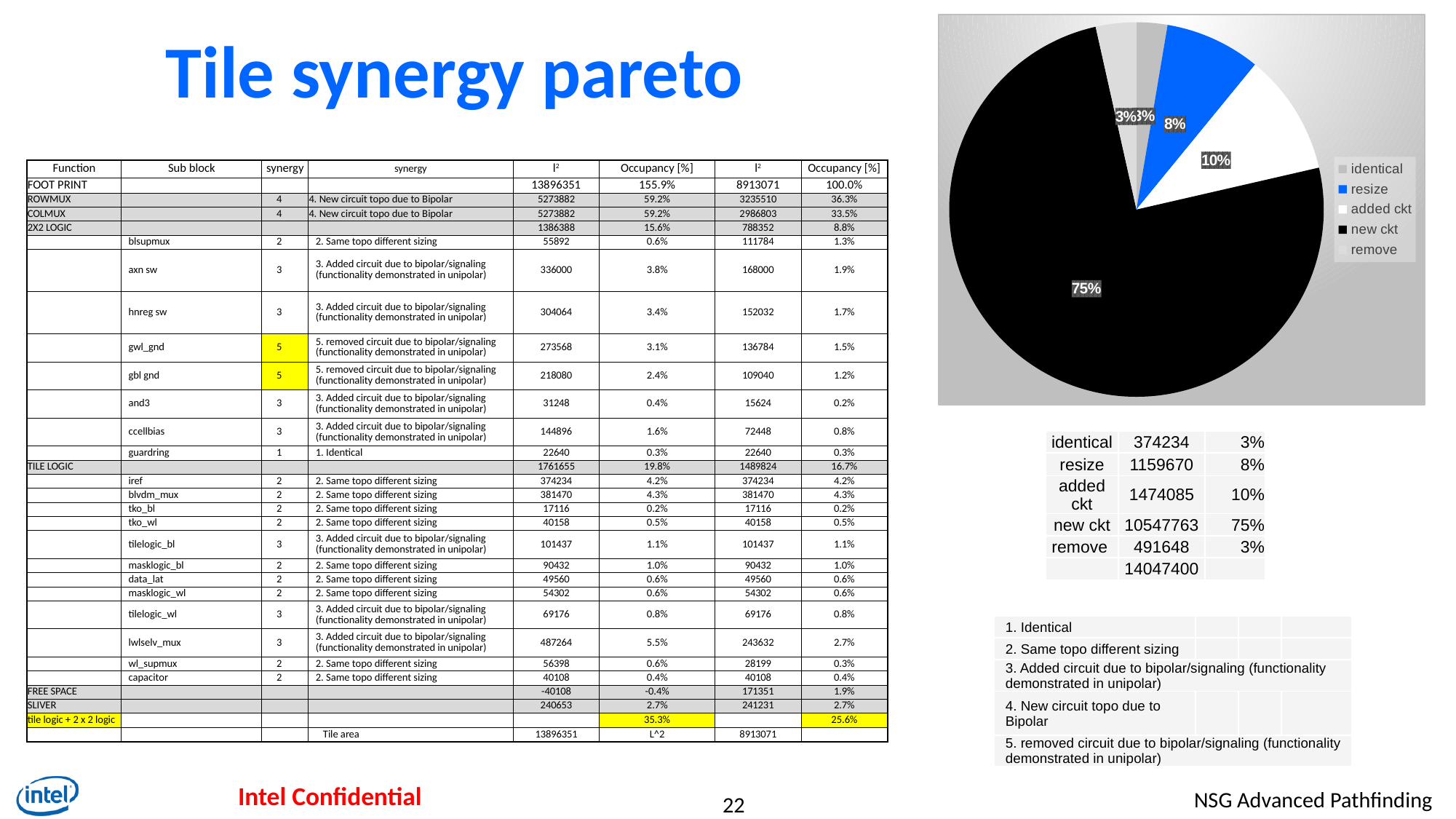
Which is larger in the pie chart, 'resize' or 'added ckt'? added ckt What share of the pie does 'added ckt' take? 10% What share of the pie does 'identical' take? 3% What is the difference in percentage points between the 'new ckt' slice and the 'added ckt' slice? 65% How many entries does the pie chart's legend list? 5 Which legend entry is listed last in the pie chart's legend? remove What share of the pie does 'new ckt' take? 75% How many slices does the pie chart have? 5 What colour is the 'resize' slice in the pie chart? blue What kind of chart is shown on the slide? pie chart Which category has the largest slice in the pie chart? new ckt